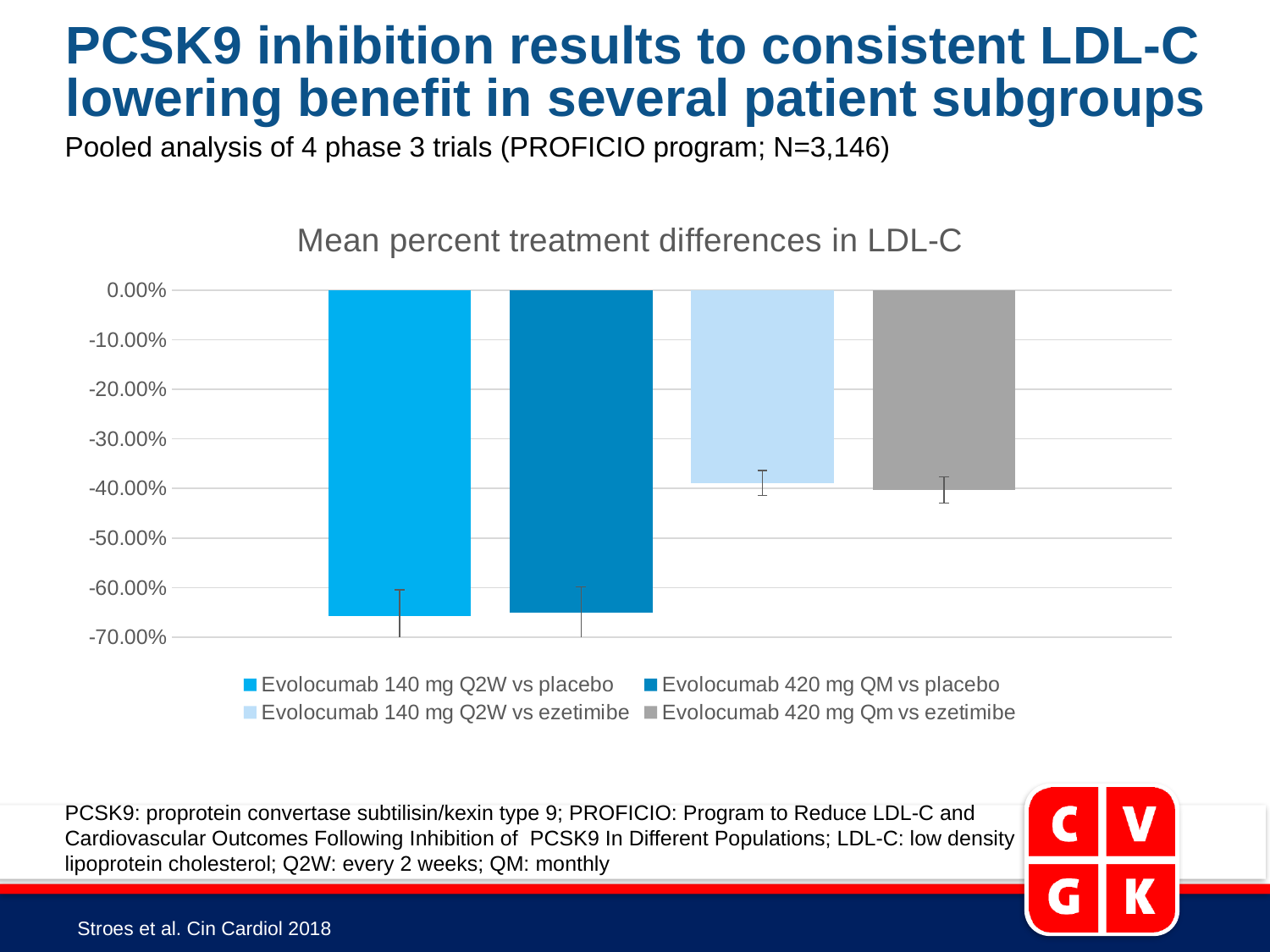
Is the value for Evolocumab 140 mg Q2W vs placebo greater or less than -70.00%? greater What kind of chart is shown on the slide? bar chart Is the value for Evolocumab 140 mg Q2W vs ezetimibe greater or less than -50.00%? greater Is the value for Evolocumab 420 mg QM vs placebo greater or less than -60.00%? less Which series is shown in grey in the chart legend? Evolocumab 420 mg Qm vs ezetimibe How many bars are plotted in the chart? 4 Which shows a larger (more negative) LDL-C treatment difference: Evolocumab 140 mg Q2W vs placebo or Evolocumab 140 mg Q2W vs ezetimibe? Evolocumab 140 mg Q2W vs placebo How many series does the chart legend list? 4 Which shows a larger (more negative) LDL-C treatment difference: Evolocumab 420 mg QM vs placebo or Evolocumab 420 mg Qm vs ezetimibe? Evolocumab 420 mg QM vs placebo What is the title of the chart? Mean percent treatment differences in LDL-C